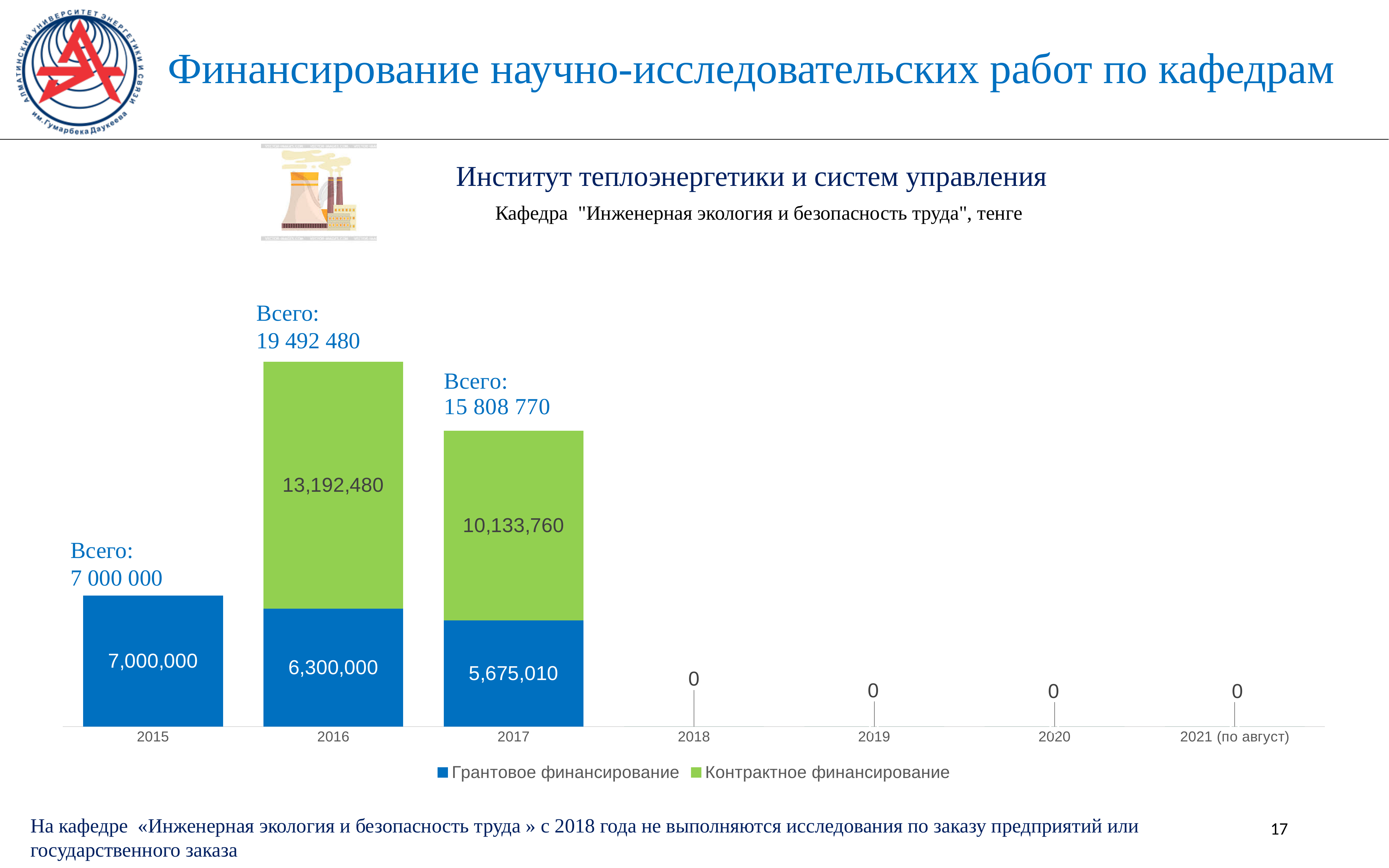
What is the value of Грантовое финансирование for 2015? 7,000,000 Which is larger: Контрактное финансирование in 2016 or in 2017? 2016 What is the total (Всего) for 2016? 19 492 480 Which year has the highest total funding? 2016 What is the total (Всего) for 2017? 15 808 770 What is the value of Контрактное финансирование for 2016? 13,192,480 What is the difference between Грантовое финансирование in 2016 and in 2017? 624,990 How many year categories are shown on the x axis? 7 What is the value of Грантовое финансирование for 2016? 6,300,000 What is the value of Контрактное финансирование for 2017? 10,133,760 How many series does the legend list? 2 What type of chart is shown on the slide? Stacked bar chart